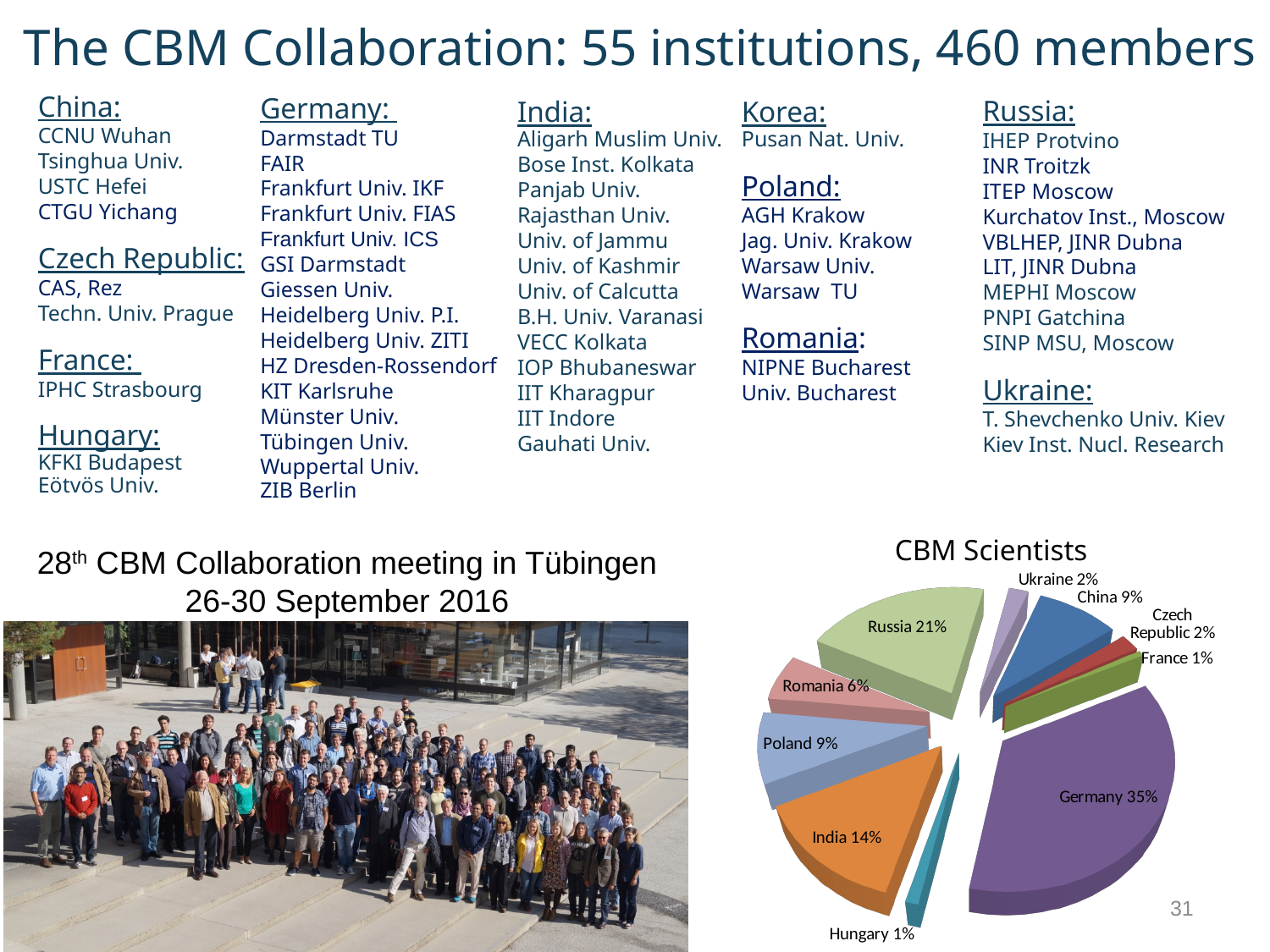
Which country has the largest slice in the CBM Scientists pie chart? Germany How many labelled slices does the CBM Scientists pie chart have? 10 In the CBM Scientists pie chart, which is larger, the share for Poland or the share for Romania? Poland In the CBM Scientists pie chart, what share is shown for Russia? 21% What is the title of the pie chart on the slide? CBM Scientists In the CBM Scientists pie chart, what share is shown for India? 14% In the CBM Scientists pie chart, what share is shown for Romania? 6% In the CBM Scientists pie chart, what is the difference between the shares for Germany and Russia? 14% In the CBM Scientists pie chart, what is the difference between the shares for India and China? 5% In the CBM Scientists pie chart, what share is shown for Germany? 35% What kind of chart is the "CBM Scientists" chart? pie chart